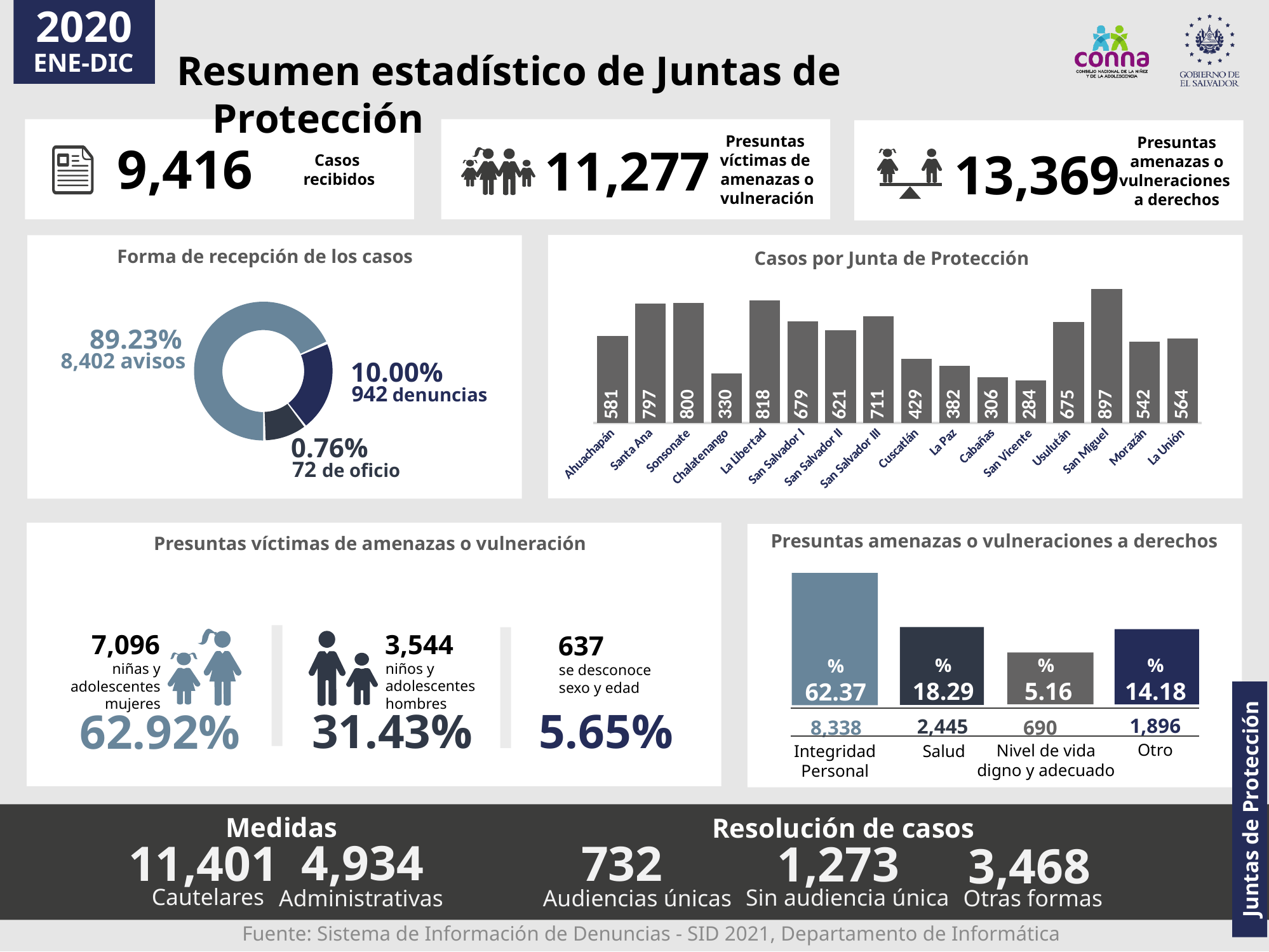
How many Juntas de Protección are shown in the 'Casos por Junta de Protección' chart? 16 In the 'Casos por Junta de Protección' chart, how many cases does San Miguel have? 897 In the 'Presuntas amenazas o vulneraciones a derechos' chart, what percentage does Integridad Personal represent? 62.37% In the 'Casos por Junta de Protección' chart, which has more cases, Santa Ana or Sonsonate? Sonsonate In the 'Forma de recepción de los casos' chart, what percentage of cases were received as avisos? 89.23% In the 'Casos por Junta de Protección' chart, which Junta has the highest number of cases? San Miguel In the 'Forma de recepción de los casos' chart, how many cases were denuncias? 942 In the 'Casos por Junta de Protección' chart, what is the difference between the cases for La Libertad and Chalatenango? 488 What type of chart is 'Casos por Junta de Protección'? Bar chart In the 'Forma de recepción de los casos' chart, which category has the smallest share? de oficio In the 'Casos por Junta de Protección' chart, which Junta has the lowest number of cases? San Vicente In the 'Presuntas amenazas o vulneraciones a derechos' chart, what is the value for Salud? 2,445